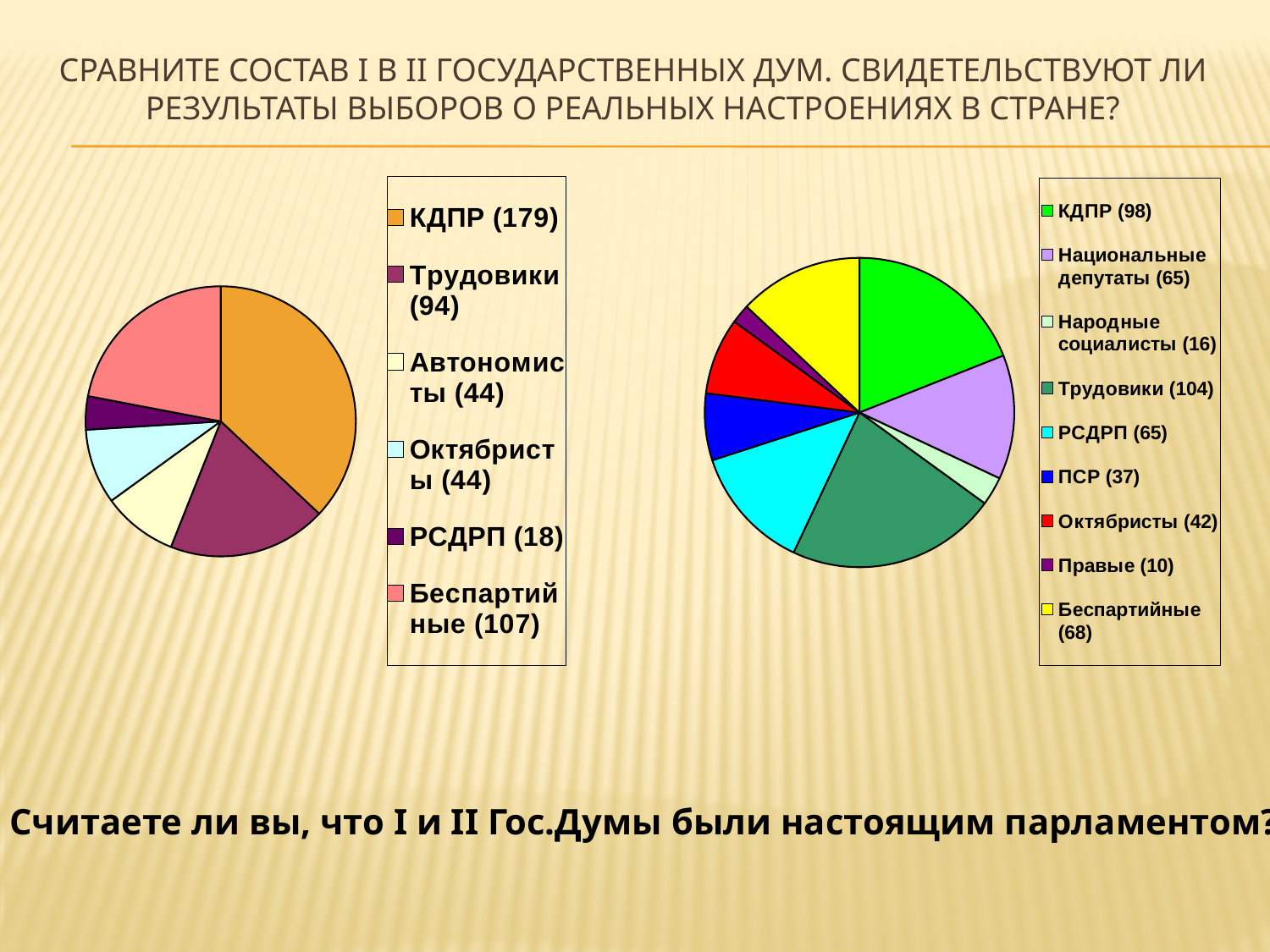
What type of chart is used on the left side of the slide? Pie chart How many categories does the legend of the left pie chart list? 6 What is the difference between the КДПР values in the left and right pie charts? 81 In the right pie chart, which category has the largest value? Трудовики In the left pie chart, how many deputies does the legend give for КДПР? 179 In the right pie chart, what value is shown for Народные социалисты? 16 How many categories does the legend of the right pie chart list? 9 In the right pie chart, which category has the smallest value? Правые In the left pie chart, which category has the smallest value? РСДРП In the left pie chart, which is larger: Беспартийные or Трудовики? Беспартийные In the right pie chart, how many deputies does the legend give for Трудовики? 104 In the left pie chart, which category has the largest value? КДПР